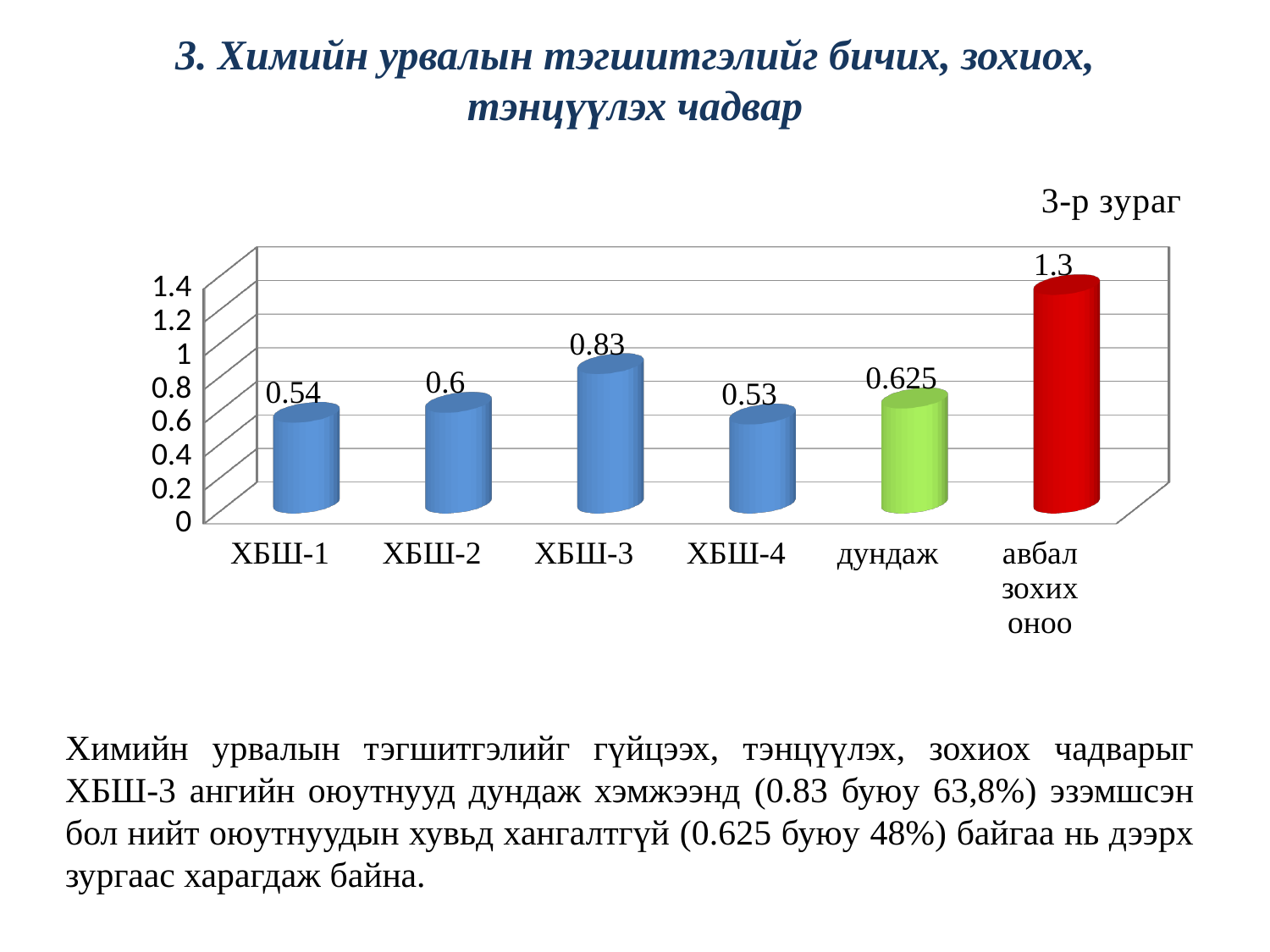
What is the value for дундаж? 0.625 What colour is the bar for авбал зохих оноо? red What is the value for авбал зохих оноо? 1.3 What is the value for ХБШ-1? 0.54 What is the difference between the values for ХБШ-3 and ХБШ-4? 0.3 Which is larger, the value for ХБШ-2 or the value for ХБШ-1? ХБШ-2 What is the value for ХБШ-3? 0.83 Which category has the highest value? авбал зохих оноо Which category has the lowest value? ХБШ-4 How many categories are shown on the x axis? 6 What is the difference between the values for авбал зохих оноо and дундаж? 0.675 What kind of chart is shown on the slide? bar chart